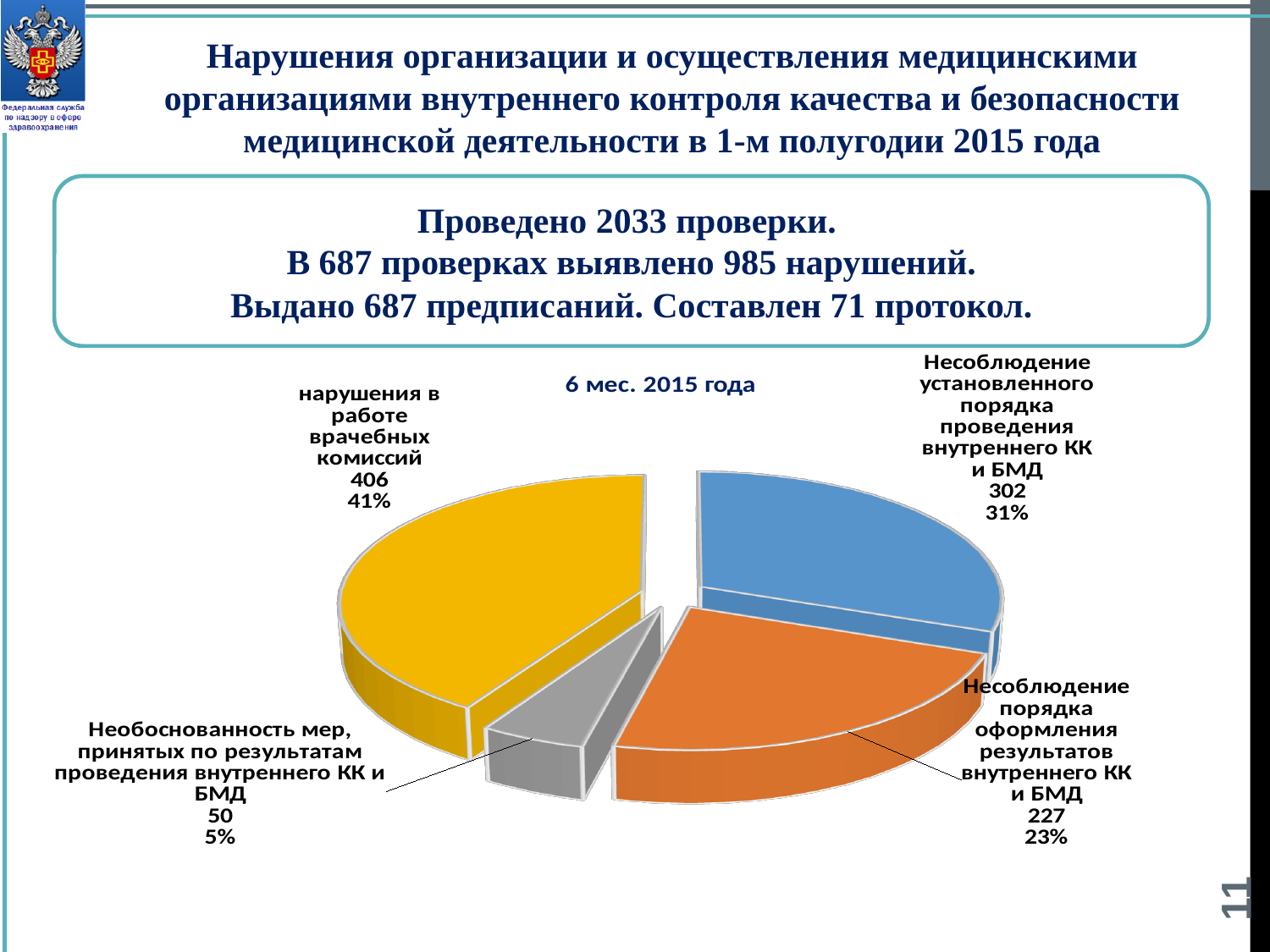
Какая категория нарушений имеет наибольшее значение на диаграмме? нарушения в работе врачебных комиссий Сколько категорий (секторов) показано на круговой диаграмме? 4 Какая категория нарушений имеет наименьшее значение на диаграмме? Необоснованность мер, принятых по результатам проведения внутреннего КК и БМД Какой тип диаграммы показан на слайде? Круговая диаграмма Какова сумма всех значений секторов диаграммы? 985 Какова доля сектора «Необоснованность мер, принятых по результатам проведения внутреннего КК и БМД»? 5% Что больше: число нарушений порядка оформления результатов внутреннего КК и БМД или число случаев необоснованности мер? Несоблюдение порядка оформления результатов внутреннего КК и БМД Какое значение указано для сектора «Несоблюдение порядка оформления результатов внутреннего КК и БМД»? 227 На сколько число нарушений в работе врачебных комиссий больше числа нарушений установленного порядка проведения внутреннего КК и БМД? 104 Какова доля сектора «Несоблюдение установленного порядка проведения внутреннего КК и БМД»? 31% Сколько нарушений в работе врачебных комиссий показано на диаграмме? 406 Какой заголовок у круговой диаграммы? 6 мес. 2015 года